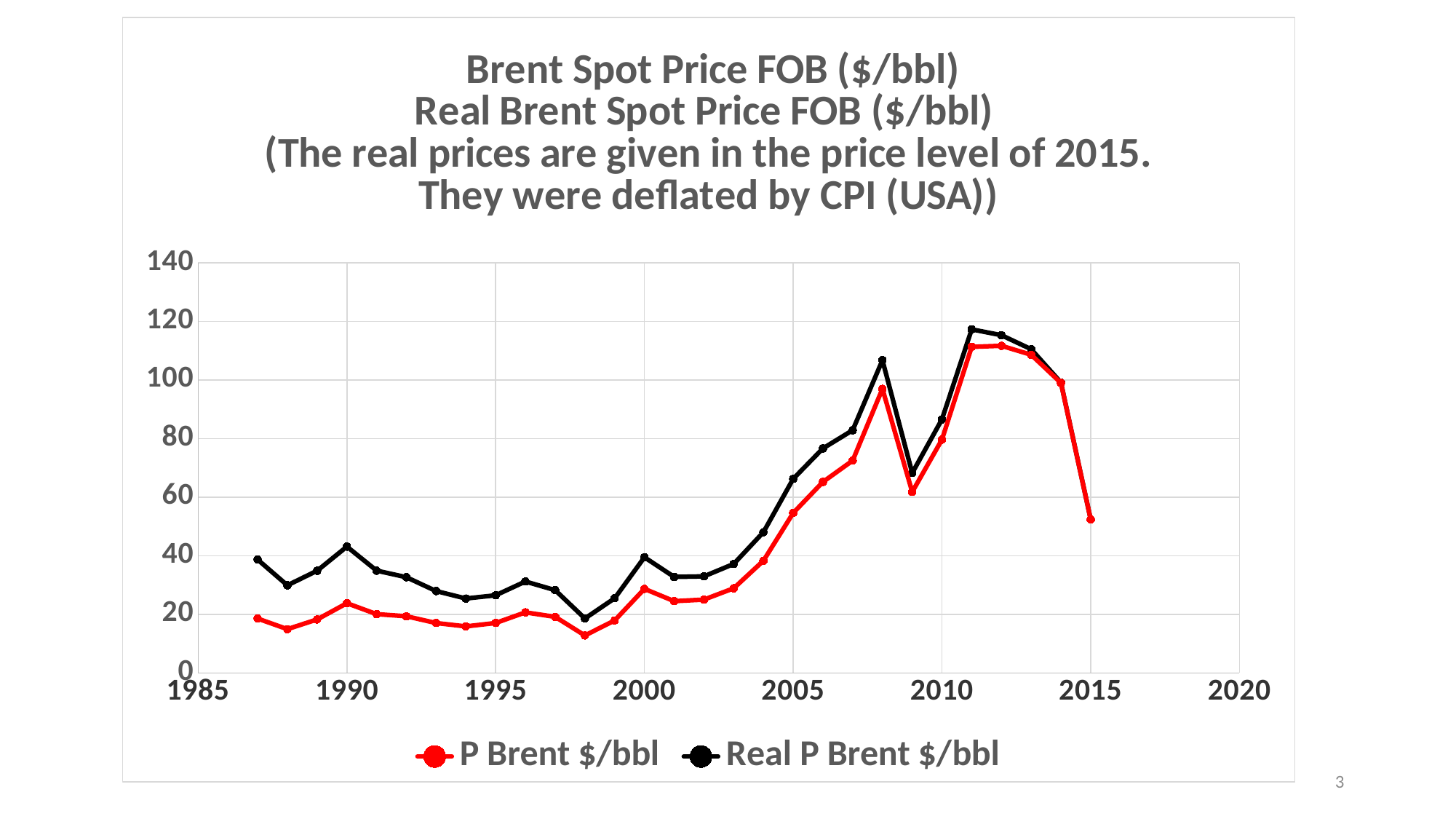
Does the P Brent $/bbl series rise or fall between 2012 and 2015? fall In 2008, which series has the higher value, P Brent $/bbl or Real P Brent $/bbl? Real P Brent $/bbl Is the value for Real P Brent $/bbl in 2005 greater or less than 60? greater In which year does the P Brent $/bbl series reach its lowest value? 1998 Which series is drawn in red? P Brent $/bbl How many series does the legend list? 2 What kind of chart is shown on the slide? line chart Is the value for Real P Brent $/bbl in 2011 greater or less than 100? greater Is the value for P Brent $/bbl in 1998 greater or less than 20? less According to the title, what price level are the real prices given in? 2015